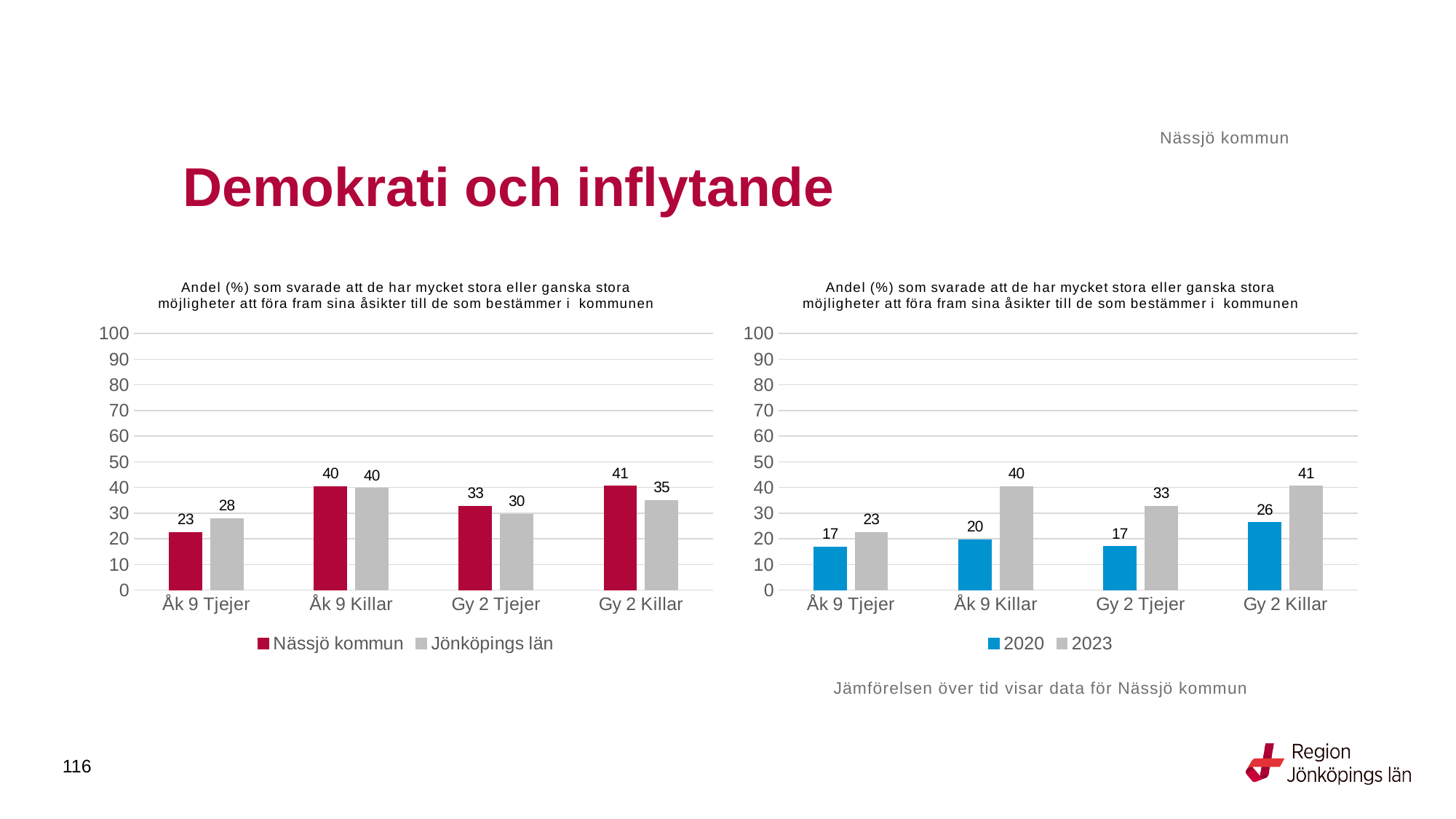
In the left chart, which category has the lowest value for Nässjö kommun? Åk 9 Tjejer In the right chart, what is the difference between the 2023 and 2020 values for Åk 9 Killar? 20 How many series does the legend of the left chart list? 2 In the left chart, what is the value for Nässjö kommun for Gy 2 Killar? 41 In the left chart, what is the value for Jönköpings län for Åk 9 Tjejer? 28 In the left chart, which is larger for Gy 2 Tjejer: Nässjö kommun or Jönköpings län? Nässjö kommun In the left chart, what is the difference between Nässjö kommun and Jönköpings län for Gy 2 Killar? 6 In the right chart, what is the 2020 value for Gy 2 Killar? 26 How many categories are shown on the x axis of the right chart? 4 What type of chart is the right chart? Bar chart In the right chart, which category has the highest 2023 value? Gy 2 Killar In the right chart, what is the 2023 value for Åk 9 Killar? 40